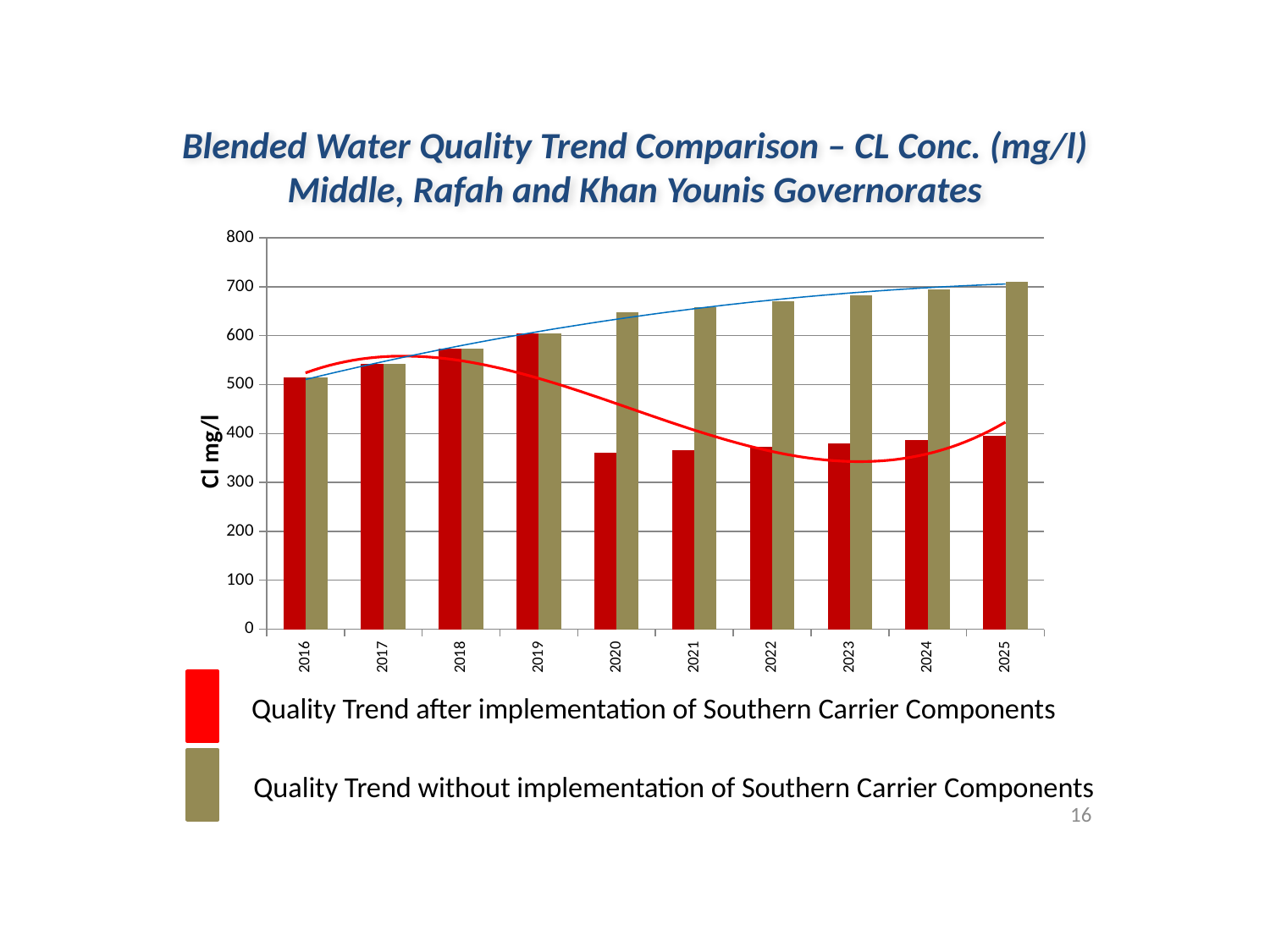
In which year is the value for 'Quality Trend without implementation of Southern Carrier Components' highest? 2025 How many years are shown on the x axis of the chart? 10 What is the label on the y axis of the chart? Cl mg/l Is the 2020 value for 'Quality Trend after implementation of Southern Carrier Components' greater or less than 400? less What kind of chart is shown on the slide? bar chart Is the 2025 value for 'Quality Trend without implementation of Southern Carrier Components' greater or less than 700? greater How many series does the legend list? 2 In 2022, which series has the larger value: 'Quality Trend after implementation' or 'Quality Trend without implementation' of Southern Carrier Components? Quality Trend without implementation of Southern Carrier Components Is the 2020 value for 'Quality Trend without implementation of Southern Carrier Components' greater or less than 600? greater Do the values for 'Quality Trend without implementation of Southern Carrier Components' rise or fall from 2016 to 2025? rise In which year is the value for 'Quality Trend after implementation of Southern Carrier Components' highest? 2019